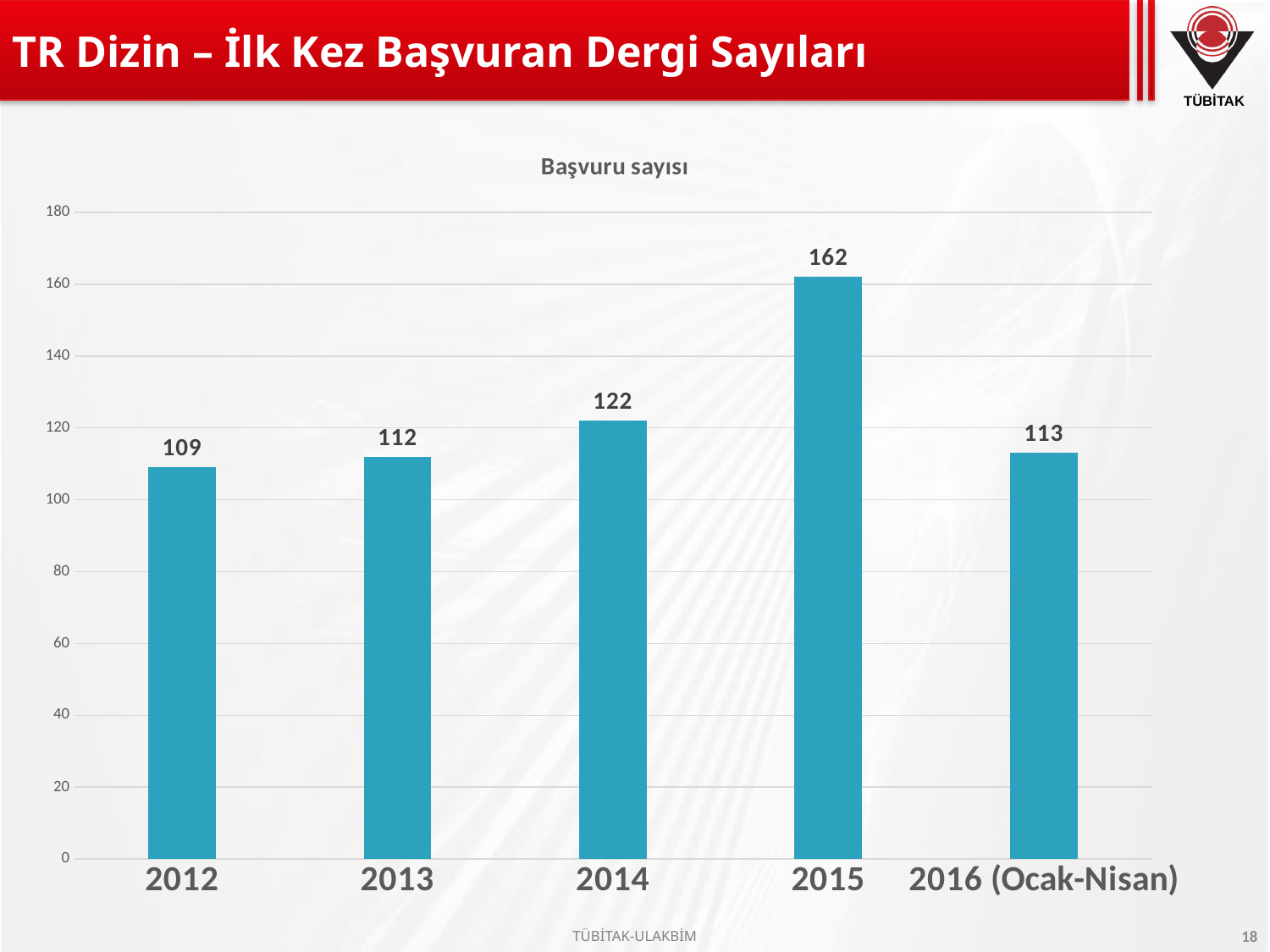
Which year has the highest value? 2015 What is the value for 2012? 109 Which category has the lowest value? 2012 What kind of chart is shown on the slide? bar chart What is the value for 2016 (Ocak-Nisan)? 113 What is the difference between the values for 2015 and 2014? 40 What is the value for 2014? 122 Is the value for 2015 greater or less than 140? greater How many categories are shown on the x axis? 5 Do the values rise or fall from 2012 to 2015? rise Which is larger, the value for 2013 or the value for 2016 (Ocak-Nisan)? 2016 (Ocak-Nisan) What is the title of the chart? Başvuru sayısı